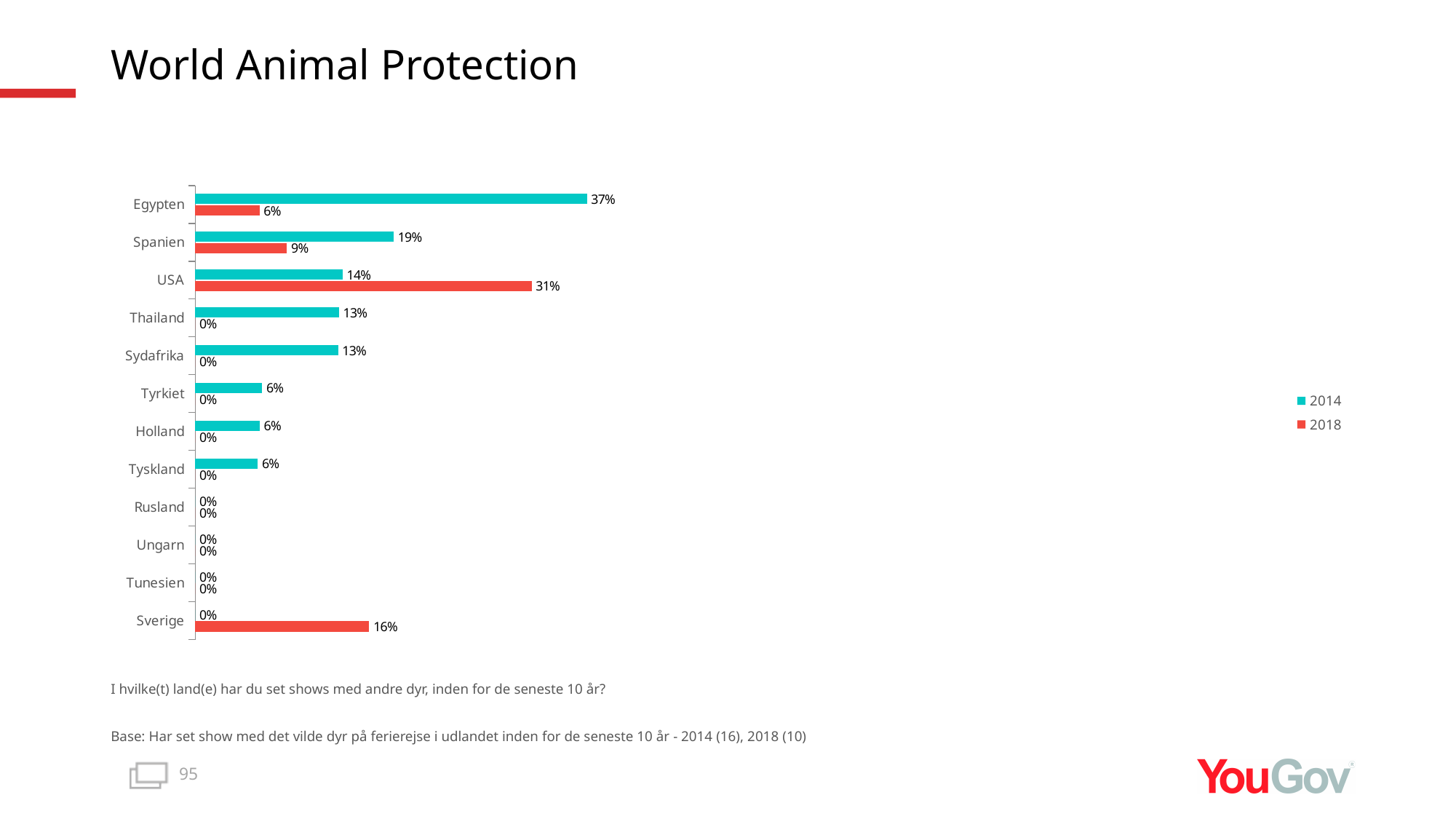
What is the difference between the 2014 and 2018 values for Egypten? 31% Which is larger for Spanien: the 2014 value or the 2018 value? 2014 Which country has the highest 2014 value? Egypten What is the 2014 value for Spanien? 19% How many countries are shown on the chart? 12 What is the 2018 value for Sverige? 16% Which country has the highest 2018 value? USA What is the 2018 value for USA? 31% What kind of chart is shown on the slide? Bar chart What is the difference between the 2018 and 2014 values for USA? 17% How many series does the legend list? 2 What is the 2014 value for Egypten? 37%